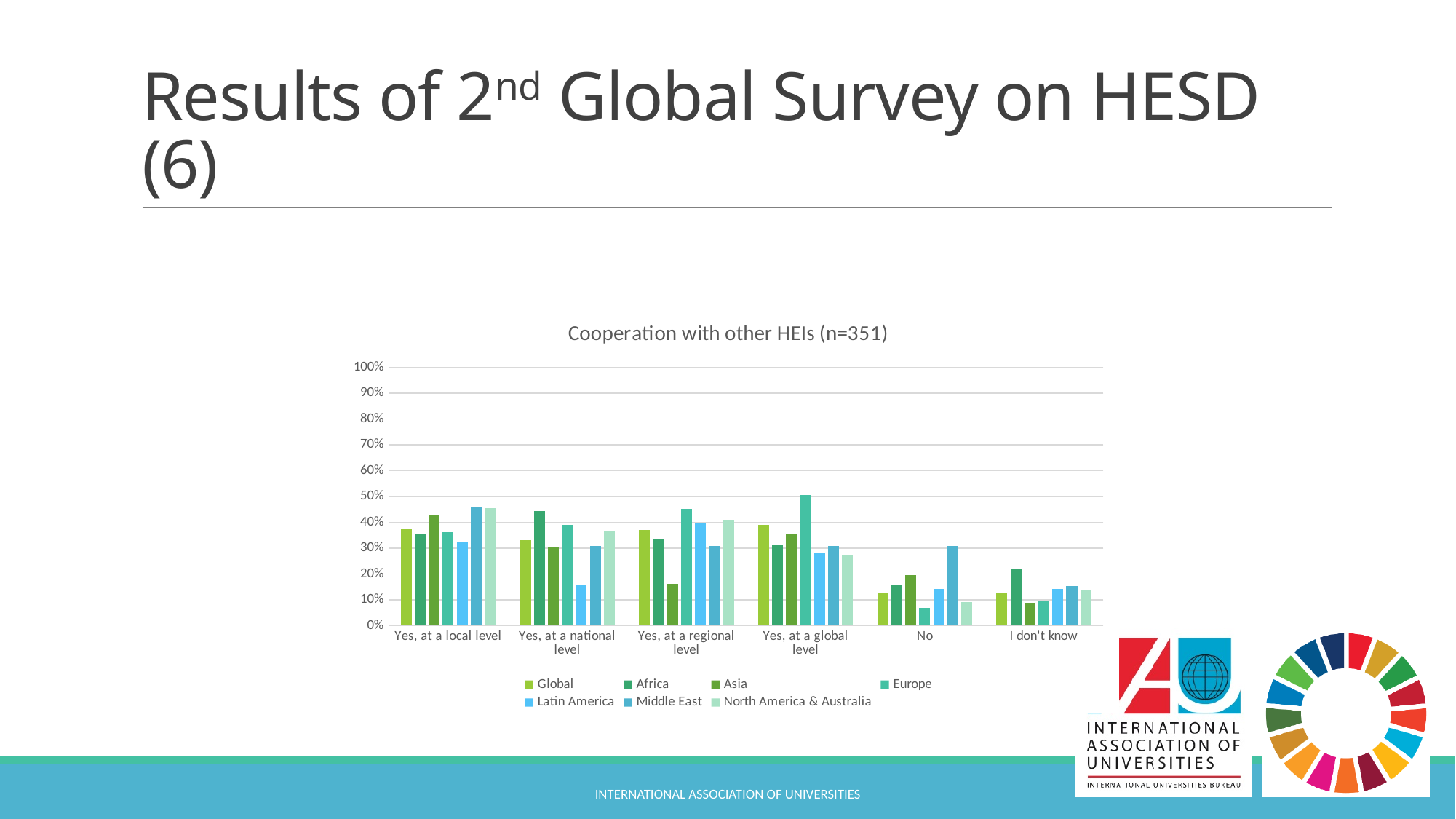
In the 'No' category, which series has the highest value? Middle East Is the value for Asia in the 'Yes, at a regional level' category greater or less than 20%? less In the 'I don't know' category, which is larger: Africa or Asia? Africa In the 'Yes, at a national level' category, which series has the highest value? Africa Is the value for Europe in the 'Yes, at a global level' category greater or less than 40%? greater In the 'Yes, at a local level' category, which is larger: Middle East or Latin America? Middle East How many series does the chart's legend list? 7 Is the value for Latin America in the 'Yes, at a national level' category greater or less than 20%? less What kind of chart is shown on the slide? bar chart What is the title of the chart? Cooperation with other HEIs (n=351) How many response categories are shown along the x axis of the chart? 6 In the 'Yes, at a regional level' category, which series has the lowest value? Asia